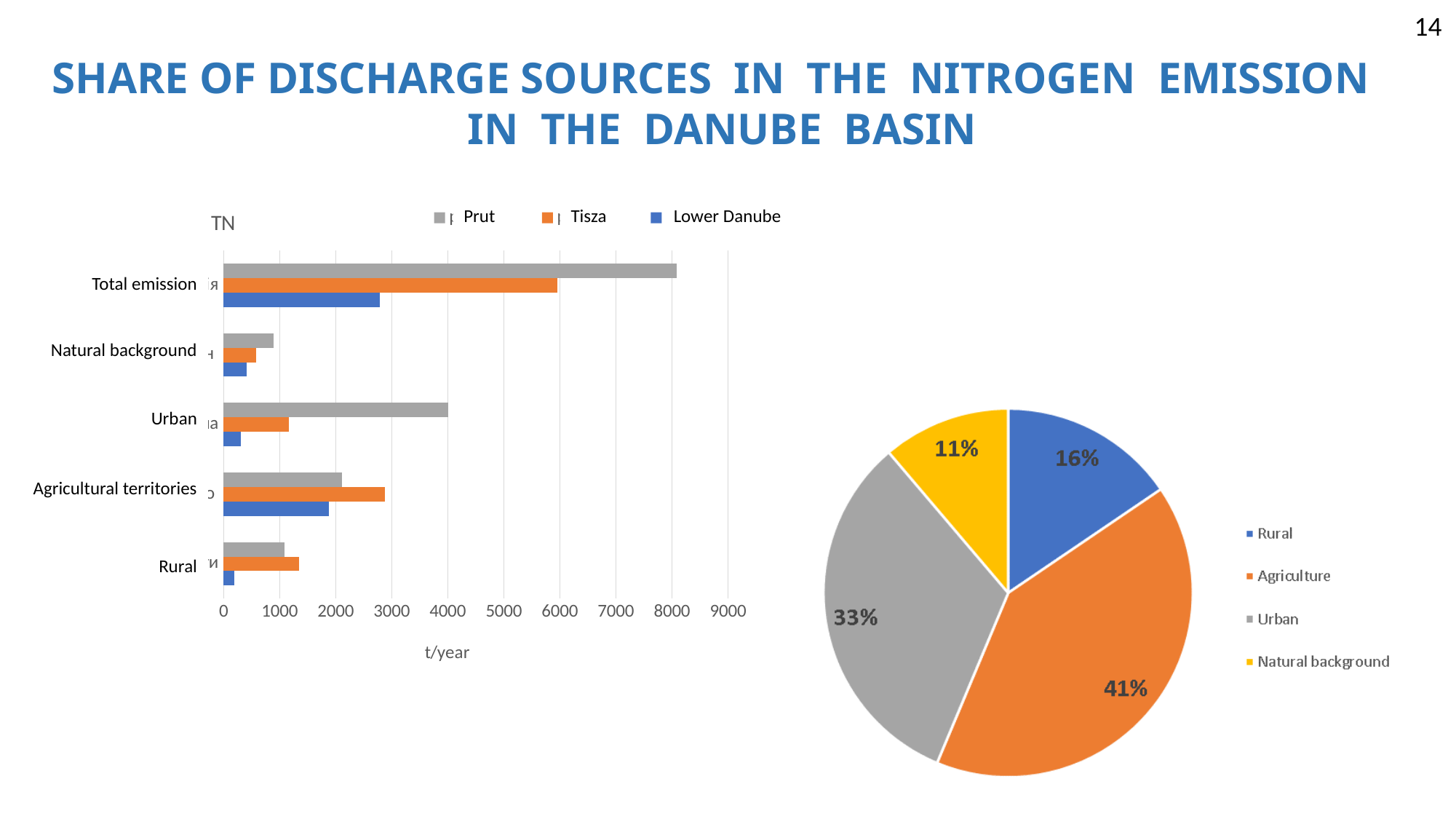
On the TN bar chart, is the Lower Danube value for Total emission greater or less than 2000? greater What kind of chart is the TN chart on the left? Bar chart On the pie chart, which category has the largest share? Agriculture On the pie chart, what is the difference between the Agriculture share and the Rural share? 25% On the TN bar chart, which series has the highest Total emission value? Prut On the pie chart, what share does Urban have? 33% On the pie chart, which category has the smallest share? Natural background On the pie chart, what share does Agriculture have? 41% On the pie chart, how many slices are there? 4 On the TN bar chart, how many series does the legend list? 3 On the TN bar chart, for Urban, which is larger: Prut or Tisza? Prut On the pie chart, what share does Natural background have? 11%